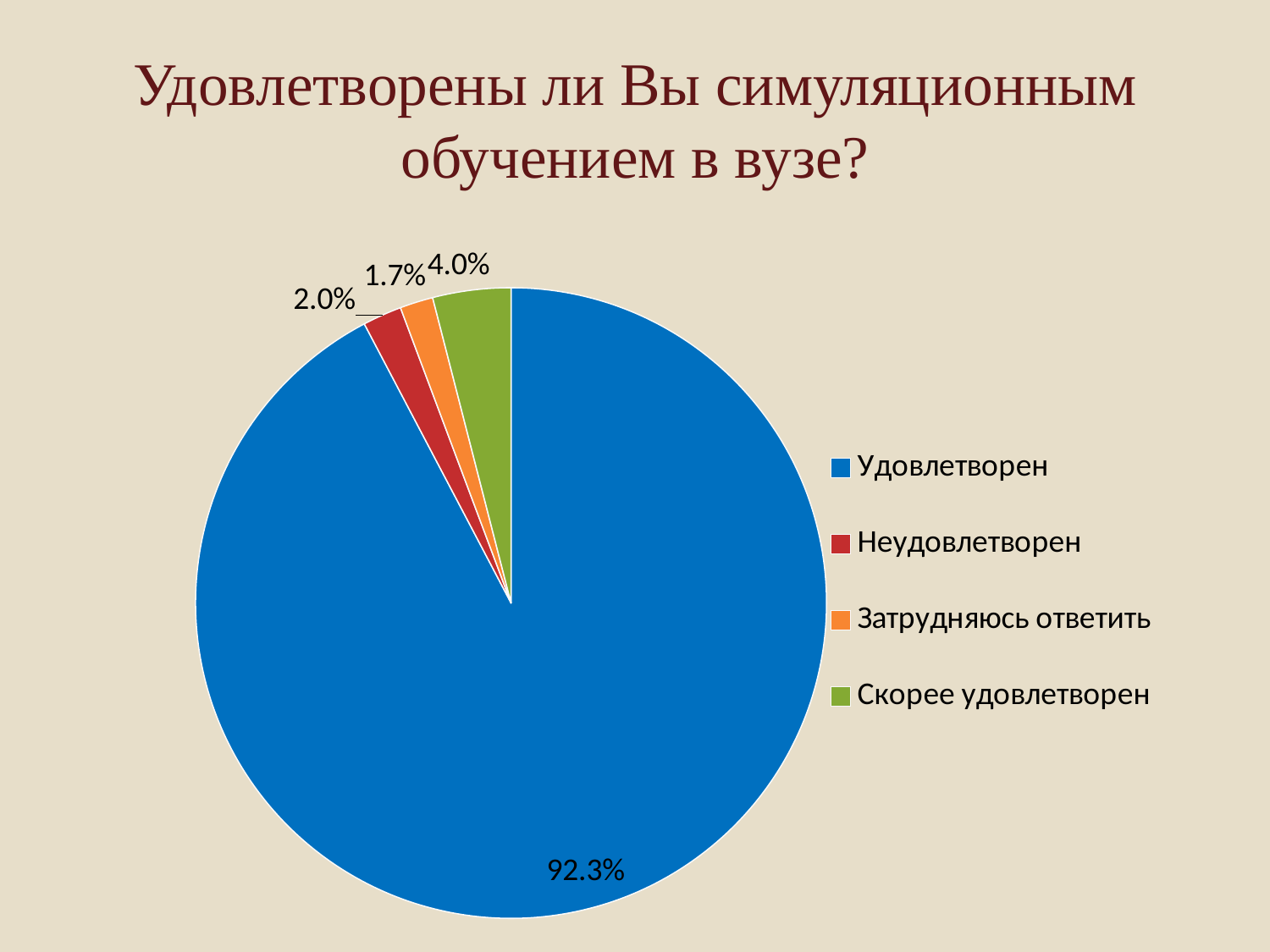
Which category has the largest slice of the pie? Удовлетворен What kind of chart is shown on the slide? pie chart Which category has the smallest slice of the pie? Затрудняюсь ответить What share of the pie is labelled for "Удовлетворен"? 92.3% Which is larger, the share for "Скорее удовлетворен" or the share for "Неудовлетворен"? Скорее удовлетворен What is the difference between the shares for "Скорее удовлетворен" and "Неудовлетворен"? 2.0% What share of the pie is labelled for "Неудовлетворен"? 2.0% What is the title of the chart? Удовлетворены ли Вы симуляционным обучением в вузе? How many categories does the legend list? 4 What colour is the slice for "Затрудняюсь ответить"? orange What share of the pie is labelled for "Скорее удовлетворен"? 4.0%